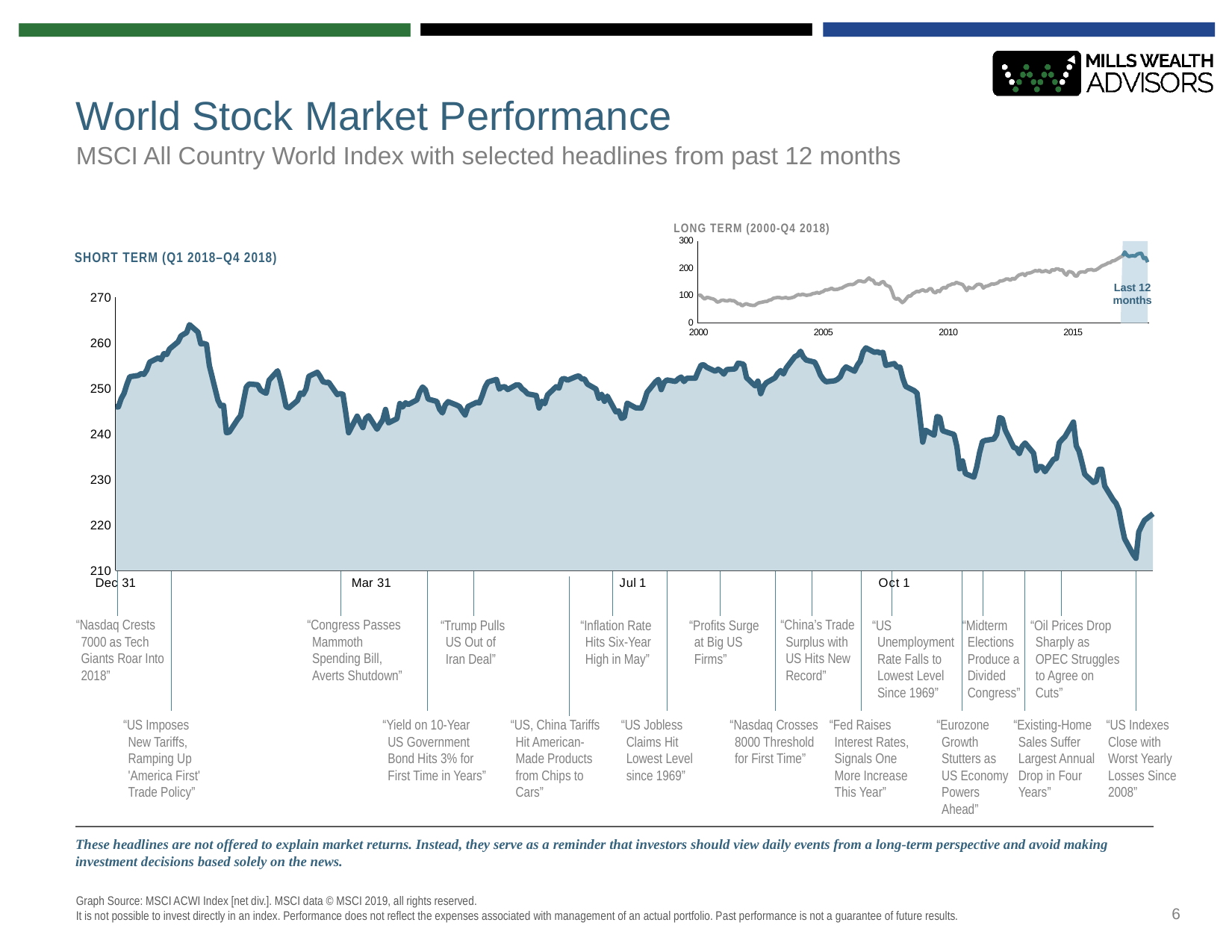
On the SHORT TERM (Q1 2018–Q4 2018) chart, does the index rise or fall overall from Dec 31 to the end of the chart? fall On the SHORT TERM (Q1 2018–Q4 2018) chart, is the value at the end of the series (late December 2018) greater or less than 230? less On the LONG TERM (2000-Q4 2018) chart, is the value at 2015 higher or lower than the value at 2005? higher On the LONG TERM (2000-Q4 2018) chart, is the value at 2010 greater or less than 100? greater On the LONG TERM (2000-Q4 2018) chart, does the index rise or fall overall from 2000 to the end of the chart? rise What kind of chart is the SHORT TERM (Q1 2018–Q4 2018) chart? line chart On the SHORT TERM (Q1 2018–Q4 2018) chart, is the value at Dec 31 greater or less than 240? greater On the SHORT TERM (Q1 2018–Q4 2018) chart, is the value at Oct 1 higher or lower than the value at Dec 31? higher What label is given to the shaded region at the right end of the LONG TERM (2000-Q4 2018) chart? Last 12 months How many date labels are shown on the x axis of the SHORT TERM (Q1 2018–Q4 2018) chart? 4